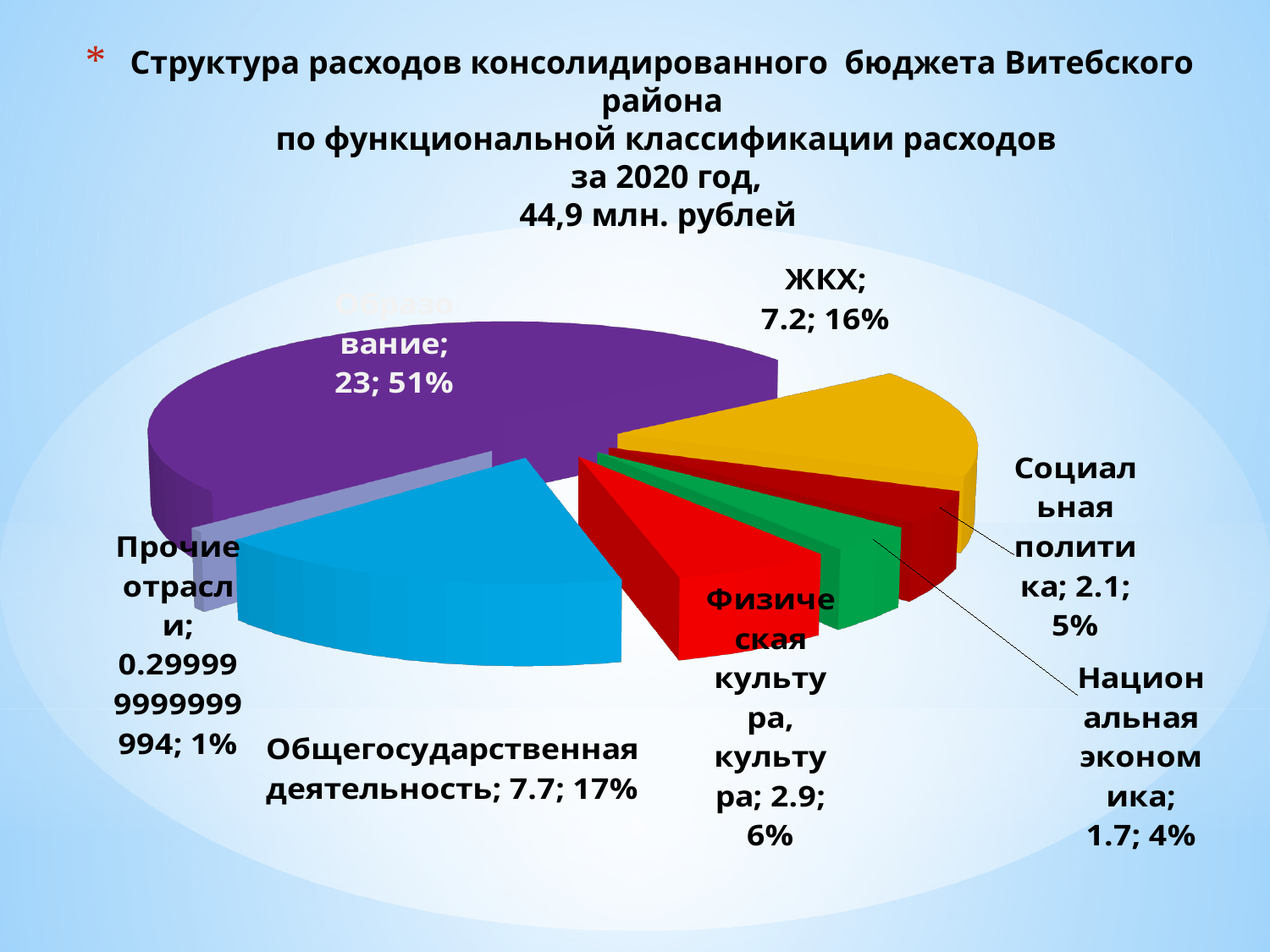
What value is shown for ЖКХ? 7.2 Which category has the largest slice? Образование What value is shown for Социальная политика? 2.1 What kind of chart is shown on the slide? Pie chart What is the difference between the values for Общегосударственная деятельность and ЖКХ? 0.5 Which is larger, the value for Физическая культура, культура or the value for Национальная экономика? Физическая культура, культура Which category has the smallest slice? Прочие отрасли What value is shown for Образование? 23 What share of the pie does Образование take? 51% What total amount in million rubles is stated in the chart title? 44,9 млн. рублей How many categories (slices) does the pie chart show? 7 What share of the pie does Общегосударственная деятельность take? 17%